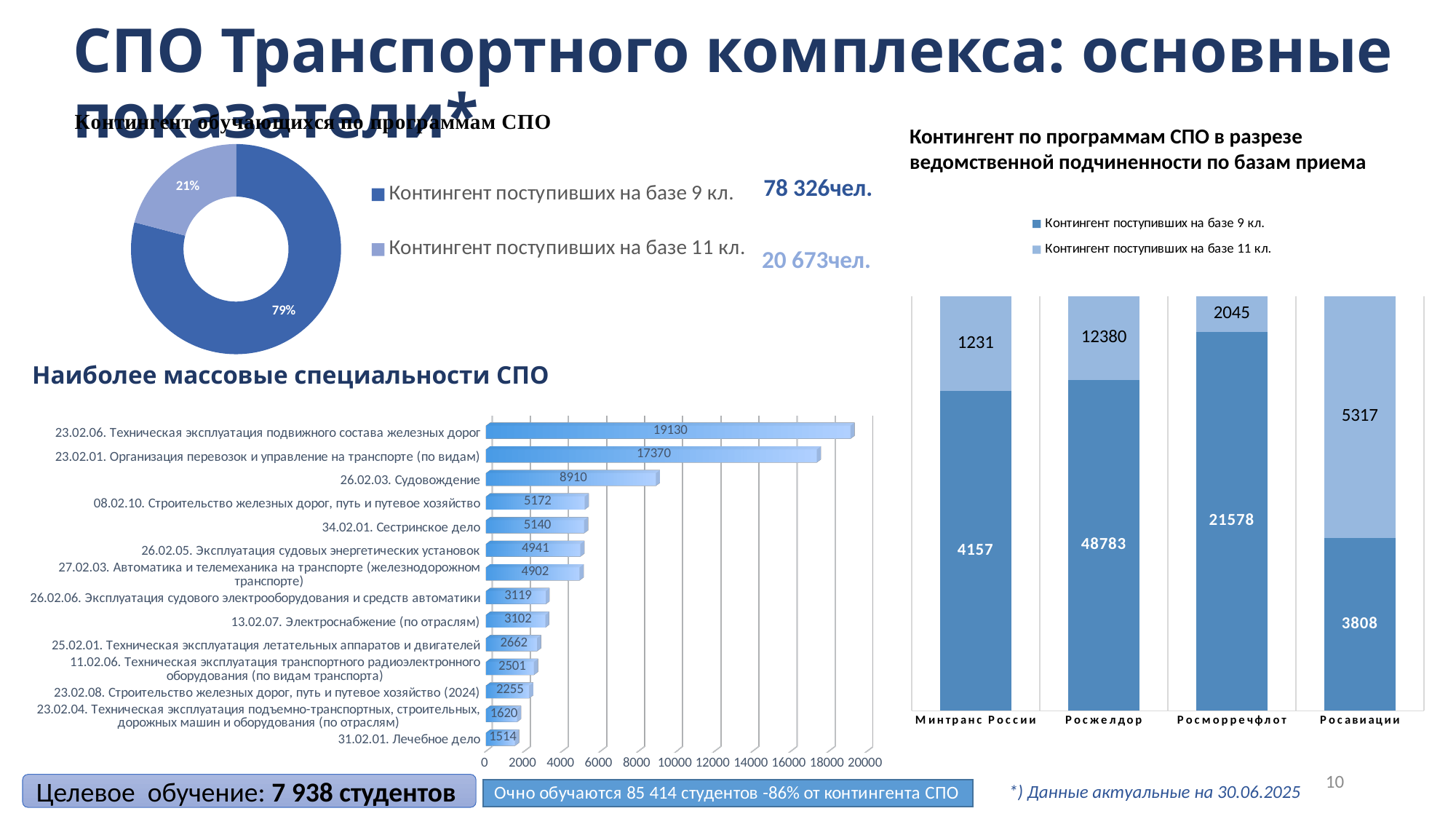
In the chart 'Наиболее массовые специальности СПО', which specialty has the lowest value? 31.02.01. Лечебное дело In the donut chart 'Контингент обучающихся по программам СПО', what share is shown for 'Контингент поступивших на базе 9 кл.'? 79% In the chart 'Наиболее массовые специальности СПО', what is the difference between the values for '23.02.06. Техническая эксплуатация подвижного состава железных дорог' and '23.02.01. Организация перевозок и управление на транспорте (по видам)'? 1760 How many specialties are listed in the chart 'Наиболее массовые специальности СПО'? 14 In the stacked bar chart 'Контингент по программам СПО в разрезе ведомственной подчиненности по базам приема', what is the value of 'Контингент поступивших на базе 9 кл.' for 'Росжелдор'? 48783 In the chart 'Наиболее массовые специальности СПО', which specialty has the highest value? 23.02.06. Техническая эксплуатация подвижного состава железных дорог What kind of chart is 'Контингент по программам СПО в разрезе ведомственной подчиненности по базам приема'? bar chart How many series does the legend of the chart 'Контингент по программам СПО в разрезе ведомственной подчиненности по базам приема' list? 2 In the chart 'Наиболее массовые специальности СПО', what is the value for '26.02.03. Судовождение'? 8910 In the stacked bar chart 'Контингент по программам СПО в разрезе ведомственной подчиненности по базам приема', which has the larger value for 'Контингент поступивших на базе 11 кл.': 'Росавиации' or 'Росморречфлот'? Росавиации In the stacked bar chart 'Контингент по программам СПО в разрезе ведомственной подчиненности по базам приема', what is the total for 'Минтранс России'? 5388 What kind of chart is 'Контингент обучающихся по программам СПО'? doughnut chart